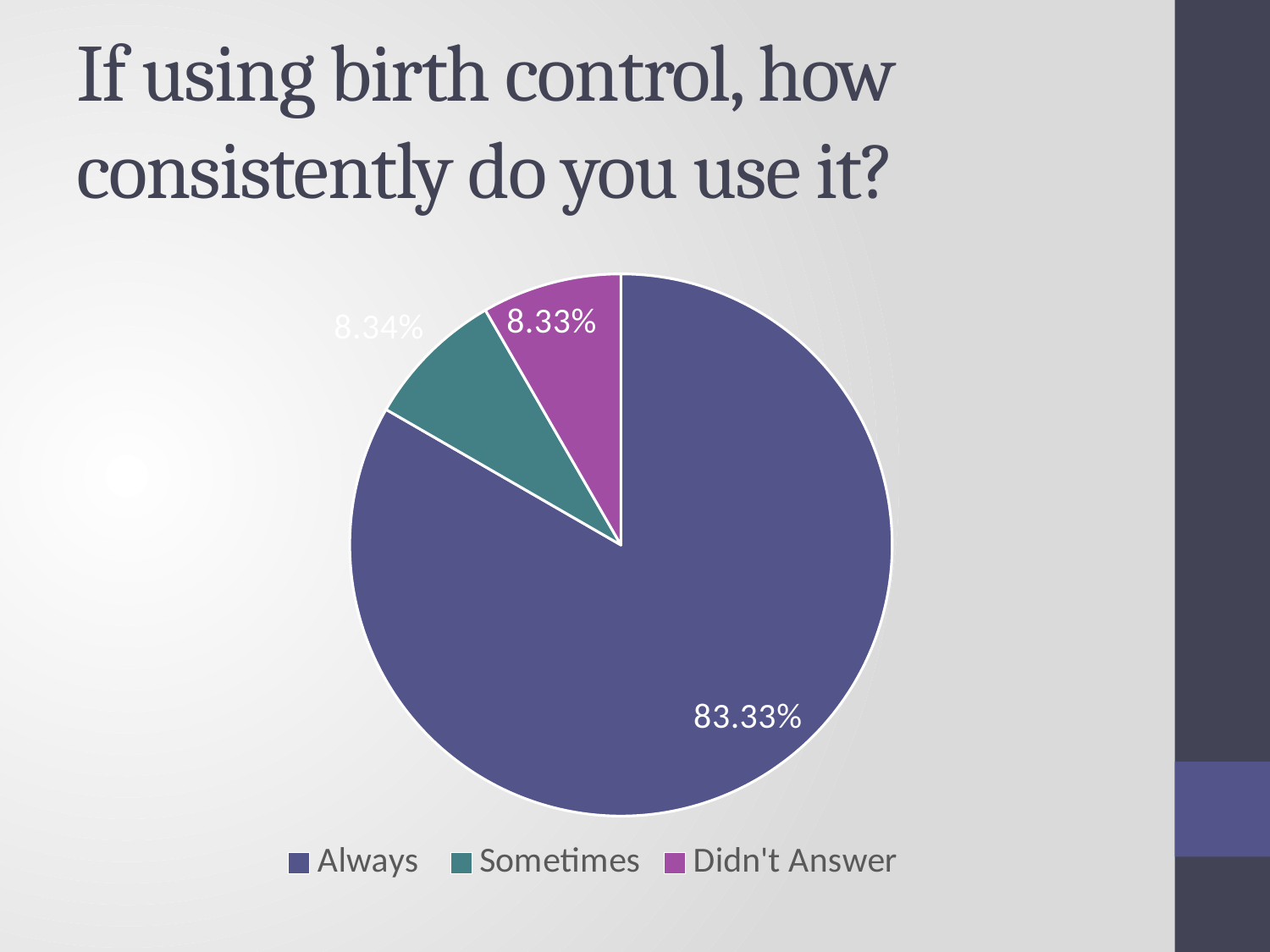
How many entries are listed in the legend? 3 What is the value shown for "Sometimes"? 8.34% Which is larger, the "Always" slice or the "Sometimes" slice? Always How many categories does the pie chart have? 3 What is the difference between the "Always" value and the "Didn't Answer" value? 75.00% What kind of chart is shown on the slide? Pie chart What is the value shown for "Didn't Answer"? 8.33% Which category has the largest slice of the pie? Always What is the title of the slide containing the chart? If using birth control, how consistently do you use it? What is the difference between the "Always" value and the "Sometimes" value? 74.99% What share of the pie does the "Always" slice represent? 83.33% What colour is the "Didn't Answer" slice? Purple/magenta